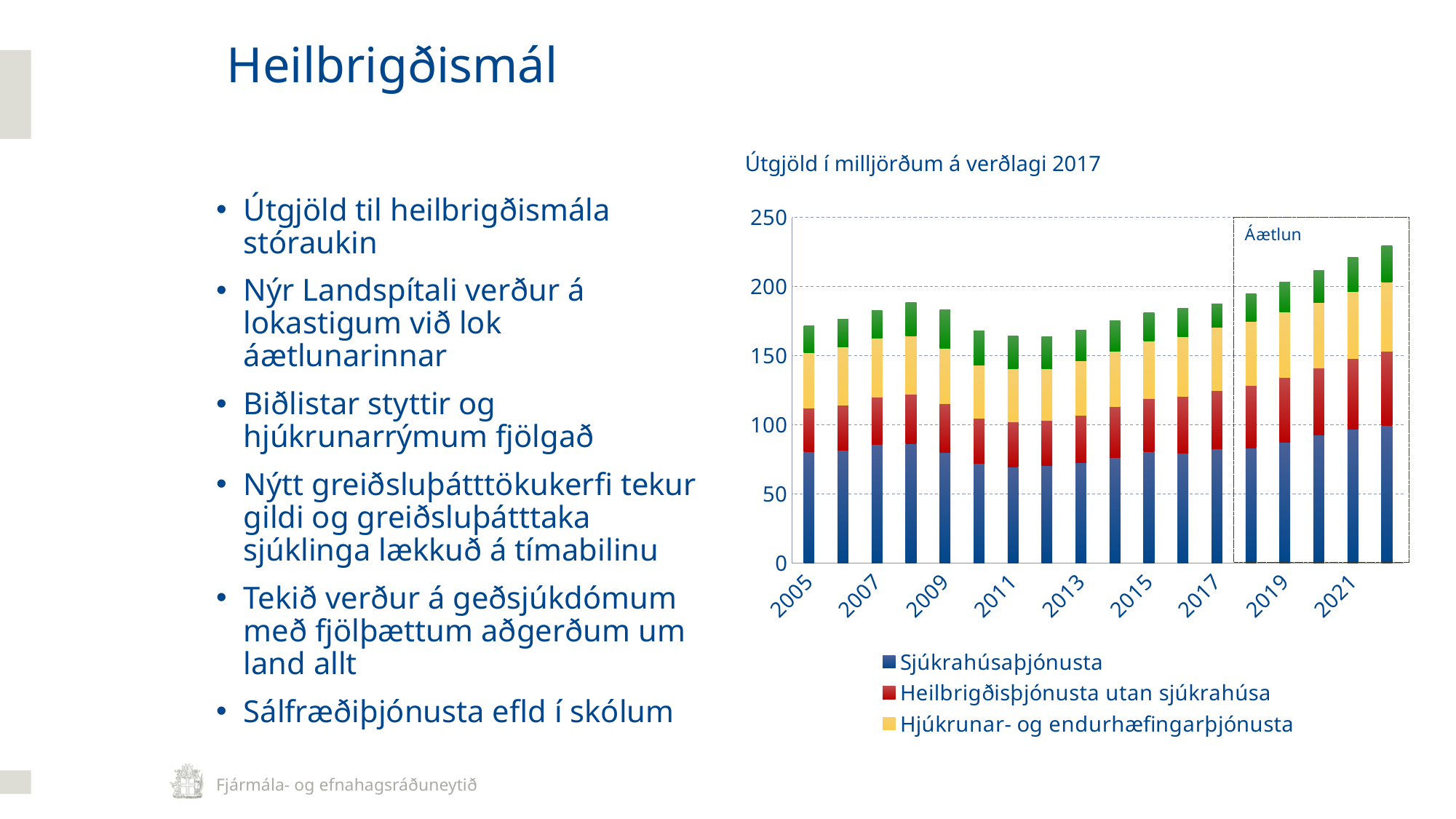
What is the title shown above the chart? Útgjöld í milljörðum á verðlagi 2017 How many bars (years) are plotted in the chart? 18 Is the Sjúkrahúsaþjónusta value for 2005 greater or less than 100? less What kind of chart is shown on the slide? Stacked bar chart How many series does the chart legend list? 3 Is the total value for 2005 greater or less than 150? greater Is the total value for 2012 greater or less than 200? less Which legend entry is shown in blue? Sjúkrahúsaþjónusta Do the total bars rise or fall from 2012 to 2022? rise Which year has the highest total bar? 2022 Which year has the larger total bar, 2008 or 2012? 2008